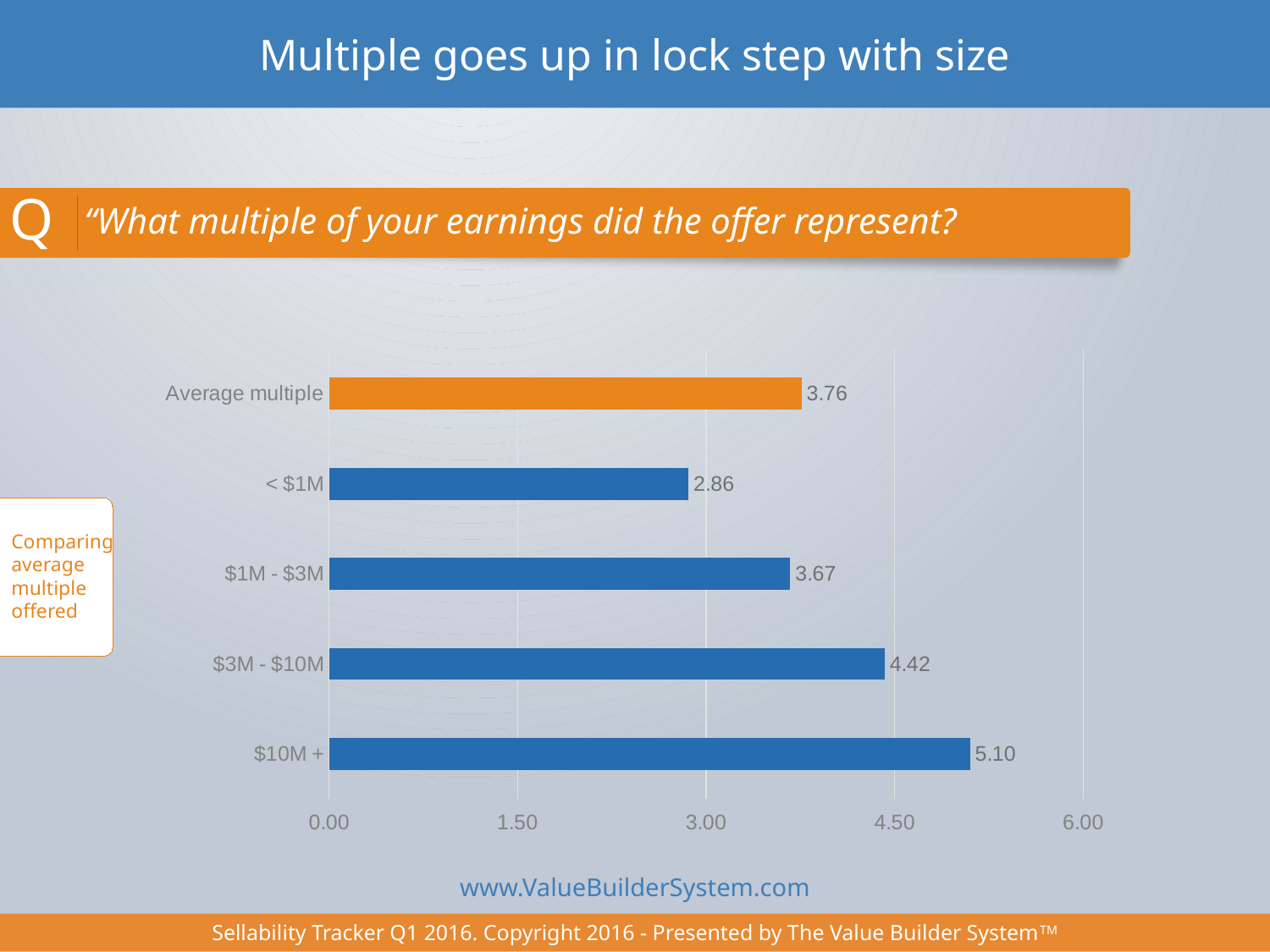
Which category has the lowest value? < $1M What is the difference between the values for $10M + and < $1M? 2.24 Is the value for $3M - $10M greater or less than 4.50? less Which category has the highest value? $10M + Which is larger, the value for $3M - $10M or the value for $1M - $3M? $3M - $10M What is the value for the $10M + category? 5.10 What is the value for the $1M - $3M category? 3.67 How many bars are shown in the chart? 5 What kind of chart is shown on the slide? bar chart What is the value for the Average multiple bar? 3.76 What is the value for the < $1M category? 2.86 What colour is the Average multiple bar? orange